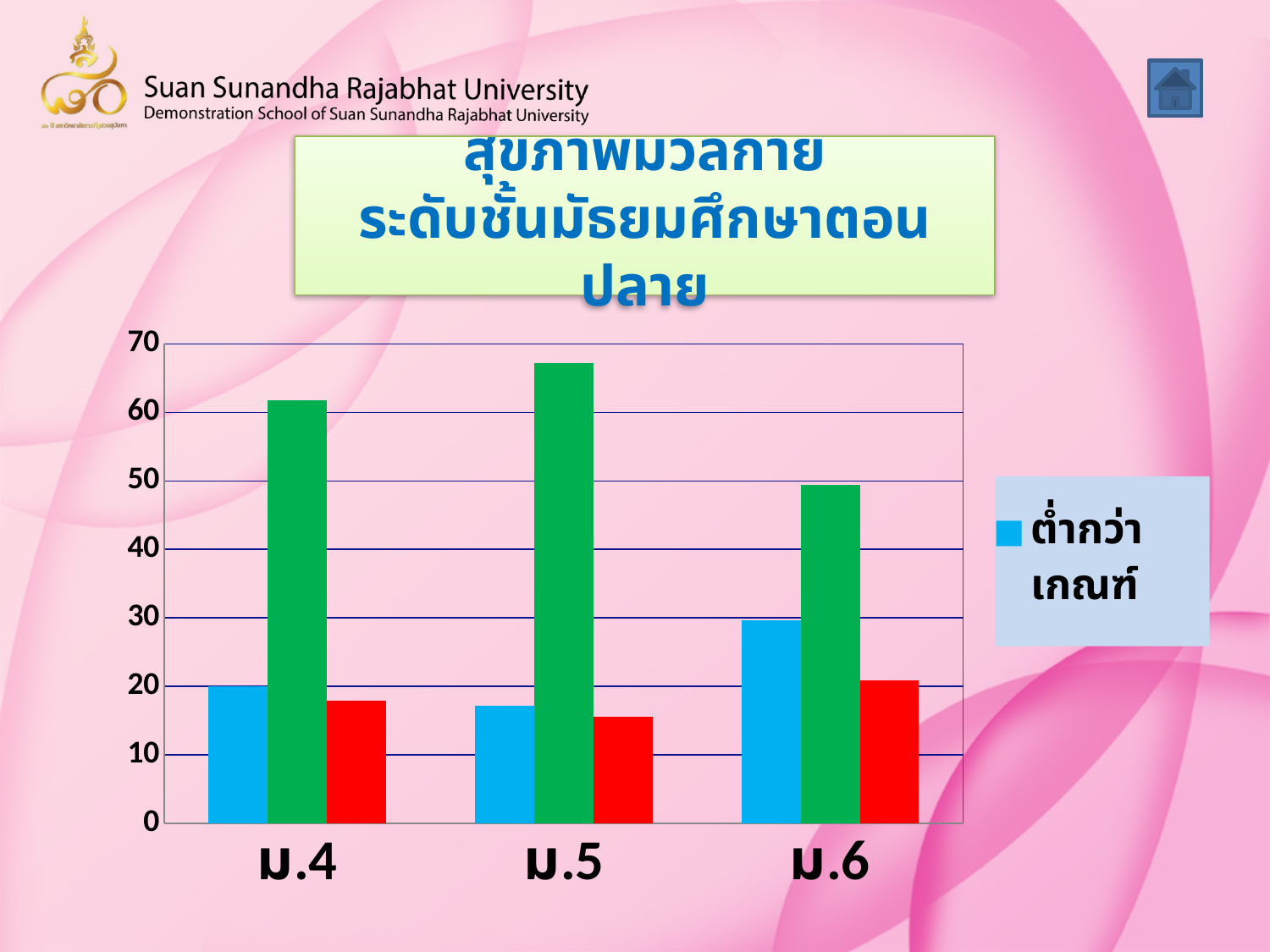
Which category has the shortest ต่ำกว่าเกณฑ์ (blue) bar? ม.5 Does the green bar rise or fall from ม.5 to ม.6? fall How many categories are shown on the x axis of the chart? 3 Is the red bar for ม.4 greater or less than 20? less Is the green bar for ม.5 greater or less than 60? greater What kind of chart is shown on the slide? bar chart Which category has the tallest green bar? ม.5 Which is larger, the green bar for ม.4 or the green bar for ม.6? ม.4 Is the ต่ำกว่าเกณฑ์ (blue) bar for ม.6 greater or less than 20? greater Which category has the tallest ต่ำกว่าเกณฑ์ (blue) bar? ม.6 What is the value of the ต่ำกว่าเกณฑ์ (blue) bar for ม.4? 20 What legend entry is shown for the blue series? ต่ำกว่าเกณฑ์